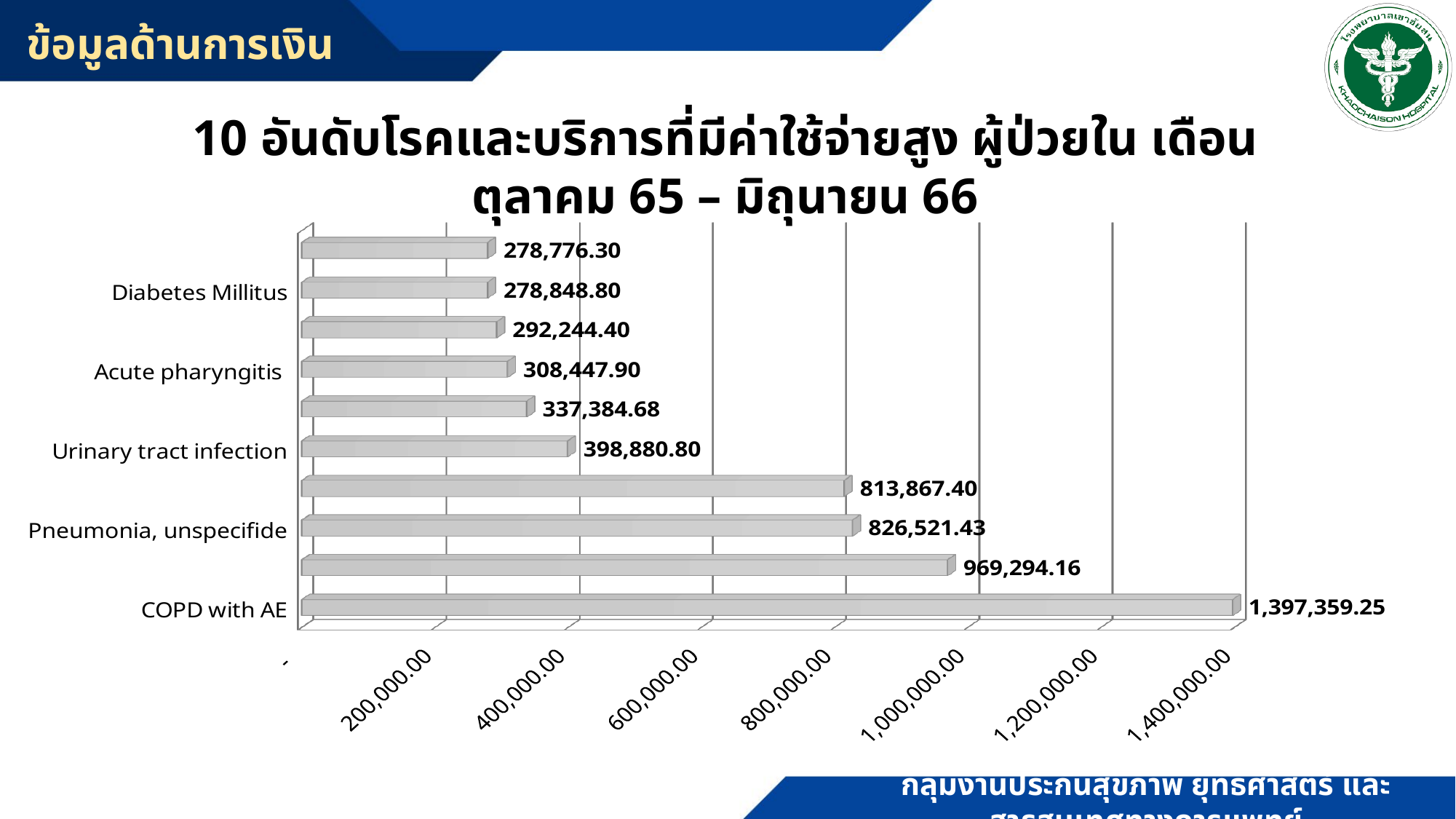
Which is larger, the value for Urinary tract infection or the value for Acute pharyngitis? Urinary tract infection What is the value for COPD with AE? 1,397,359.25 Which category has the highest value in the chart? COPD with AE How many bars are plotted in the chart? 10 What is the value for Diabetes Millitus? 278,848.80 What is the smallest value shown in the chart? 278,776.30 Is the value for Pneumonia, unspecifide greater or less than 800,000.00? greater What is the value for Urinary tract infection? 398,880.80 What is the value for Acute pharyngitis? 308,447.90 What is the value for Pneumonia, unspecifide? 826,521.43 What type of chart is shown on the slide? Bar chart What is the difference between the values for COPD with AE and Pneumonia, unspecifide? 570,837.82